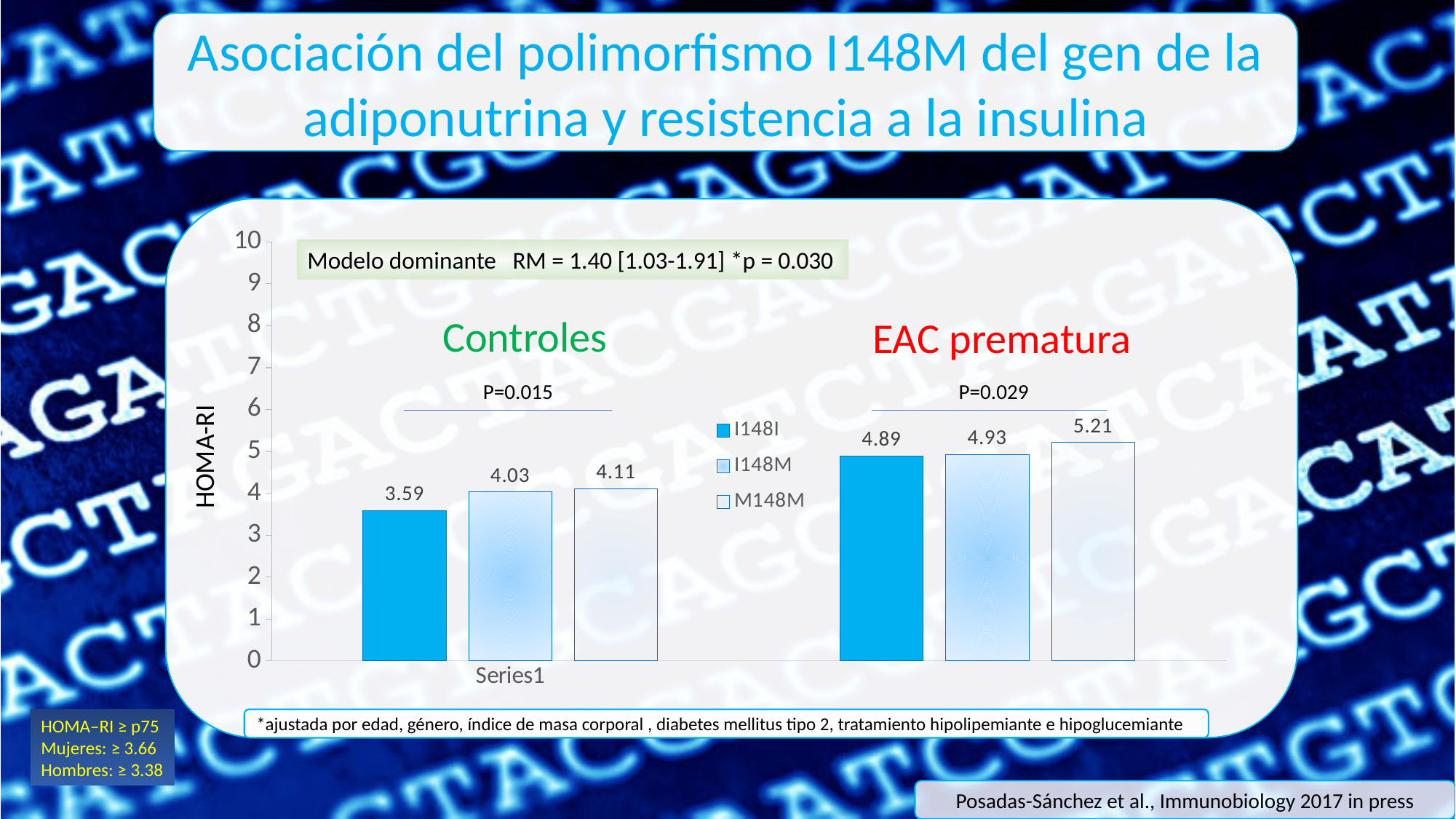
What kind of chart is shown on the slide? Bar chart What is the HOMA-RI value for the M148M genotype in the EAC prematura group? 5.21 What is the label of the vertical axis of the chart? HOMA-RI How many series does the legend list? 3 Which genotype has the highest HOMA-RI value in the EAC prematura group? M148M What is the HOMA-RI value for the I148I genotype in the EAC prematura group? 4.89 What is the difference between the I148I HOMA-RI values of the EAC prematura and Controles groups? 1.30 Which genotype has the lowest HOMA-RI value in the Controles group? I148I What is the HOMA-RI value for the I148I genotype in the Controles group? 3.59 What is the HOMA-RI value for the I148M genotype in the Controles group? 4.03 Which is larger: the M148M value in the Controles group or the I148I value in the EAC prematura group? I148I in EAC prematura What is the difference between the M148M and I148I HOMA-RI values in the Controles group? 0.52